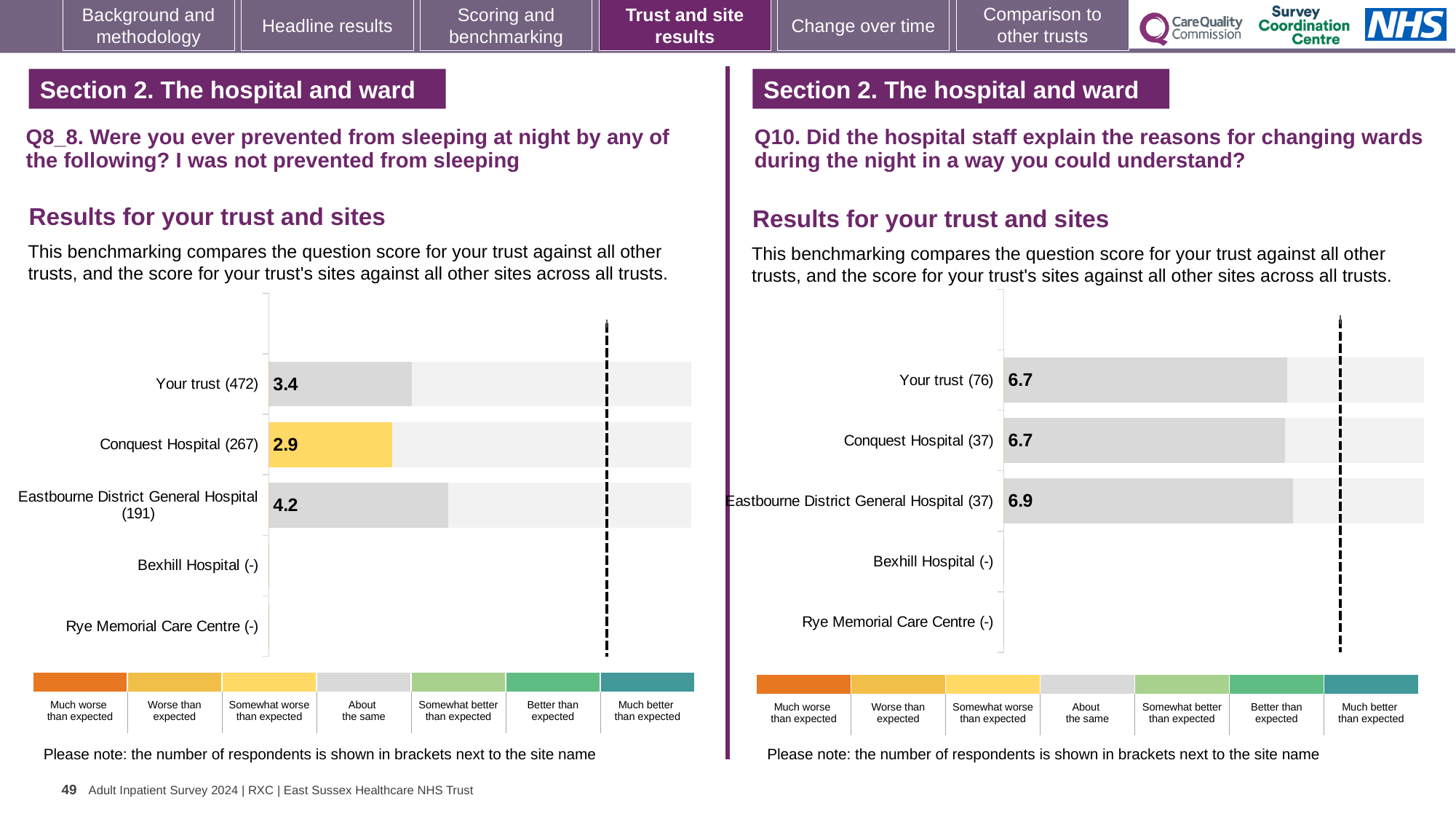
In the left chart (Q8_8), what is the difference between the scores for Eastbourne District General Hospital and Conquest Hospital? 1.3 In the right chart (Q10), what is the difference between the scores for Eastbourne District General Hospital and Conquest Hospital? 0.2 In the left chart (Q8_8), how many respondents are shown for Your trust? 472 In the right chart (Q10), what is the score for Eastbourne District General Hospital? 6.9 In the right chart (Q10), which site has the highest score? Eastbourne District General Hospital In the left chart (Q8_8), which site has the lowest score? Conquest Hospital What kind of chart is used on the left side of the slide (Q8_8)? Bar chart In the left chart (Q8_8), which site has the highest score? Eastbourne District General Hospital In the left chart (Q8_8), what is the score for Your trust? 3.4 In the left chart (Q8_8), what is the score for Conquest Hospital? 2.9 In the right chart (Q10), what is the score for Your trust? 6.7 In the left chart (Q8_8), which benchmark category does the colour of the Conquest Hospital bar correspond to? Somewhat worse than expected